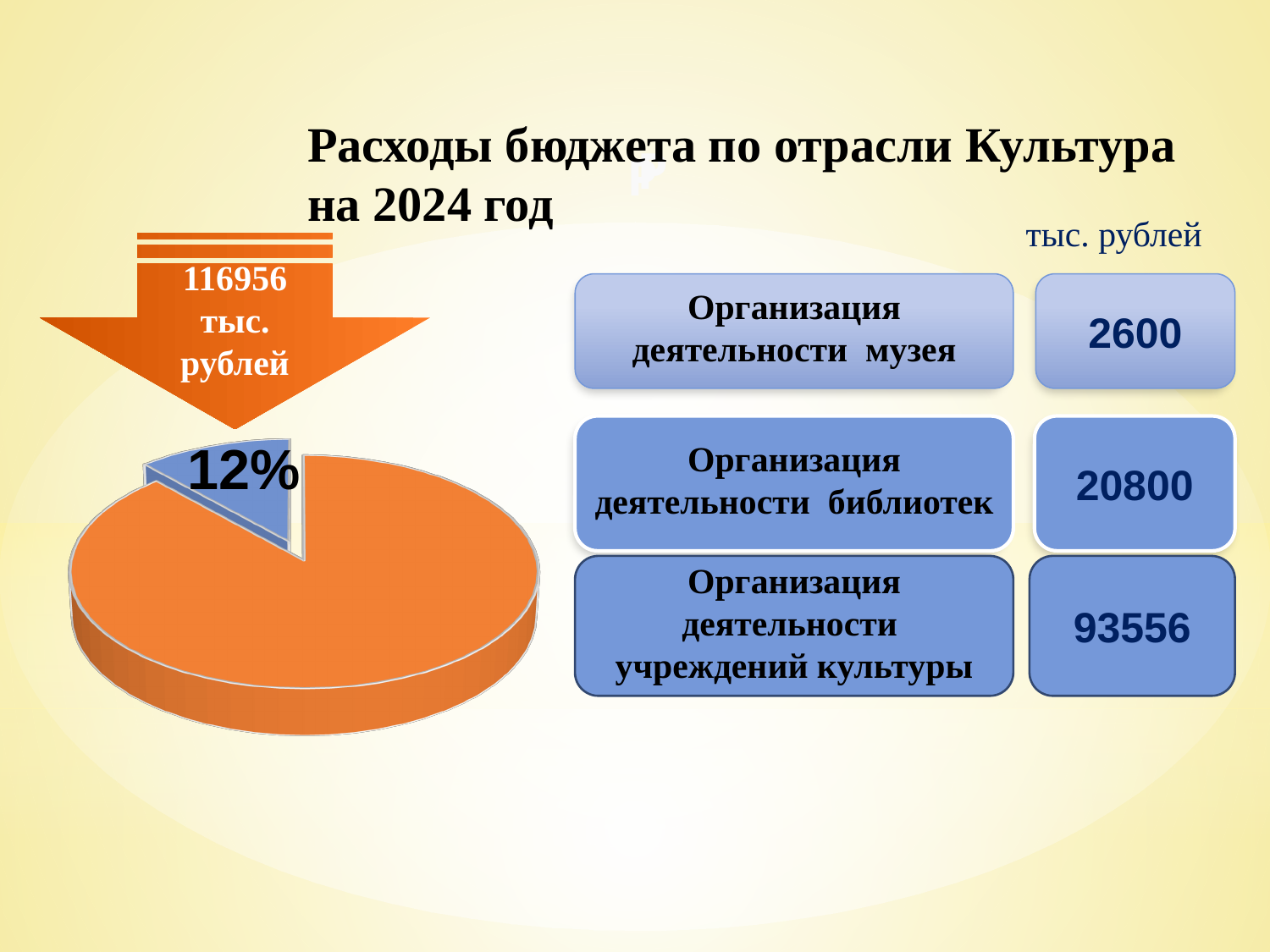
Which slice of the pie chart is the largest? the orange slice Which slice of the pie chart is larger, the blue one or the orange one? the orange one Which slice of the pie chart is the smallest? the blue slice (12%) What colour is the slice labelled 12% in the pie chart? blue How many slices does the pie chart have? 2 What kind of chart is shown on the slide? pie chart Is the orange slice of the pie chart greater or less than 50% of the pie? greater What is the title shown above the chart on the slide? Расходы бюджета по отрасли Культура на 2024 год What percentage is printed on the small blue slice of the pie chart? 12%